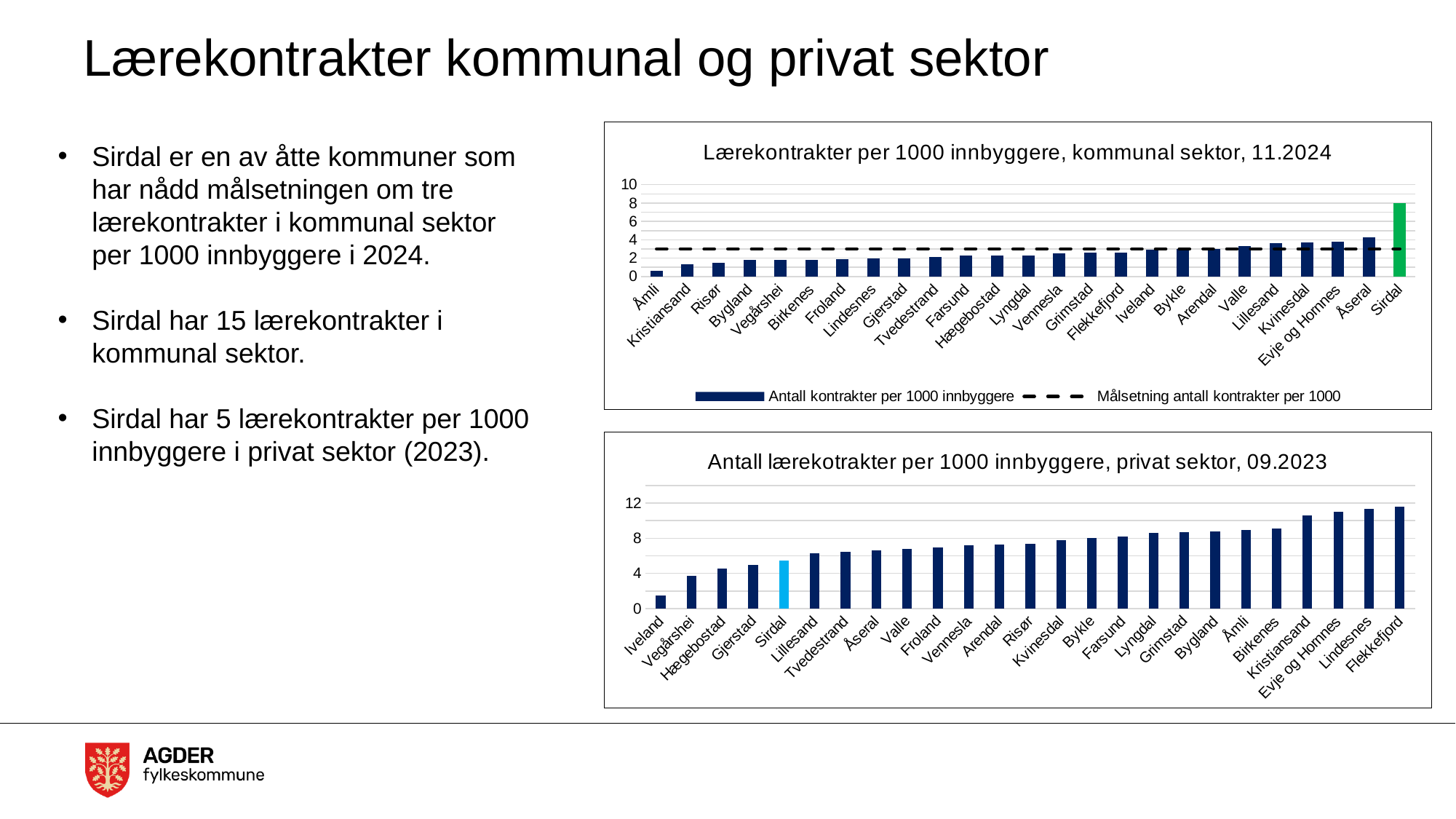
What kind of chart is the top chart, 'Lærekontrakter per 1000 innbyggere, kommunal sektor, 11.2024'? Combination bar and line chart (bars with a dashed target line) In the bottom chart (privat sektor, 09.2023), which has the larger value, Kristiansand or Gjerstad? Kristiansand In the top chart (kommunal sektor, 11.2024), which municipality has the highest value? Sirdal In the top chart (kommunal sektor, 11.2024), is the value for Sirdal greater or less than 6? greater In the bottom chart (privat sektor, 09.2023), which municipality has the highest value? Flekkefjord How many municipalities are shown in the top chart (kommunal sektor, 11.2024)? 25 In the bottom chart (privat sektor, 09.2023), which municipality has the lowest value? Iveland How many entries does the legend of the top chart (kommunal sektor, 11.2024) list? 2 In the top chart (kommunal sektor, 11.2024), do the bar values rise or fall from left to right? Rise In the top chart (kommunal sektor, 11.2024), is the value for Åmli greater or less than 2? less In the bottom chart (privat sektor, 09.2023), is the value for Sirdal greater or less than 4? greater In the top chart (kommunal sektor, 11.2024), which municipality has the lowest value? Åmli